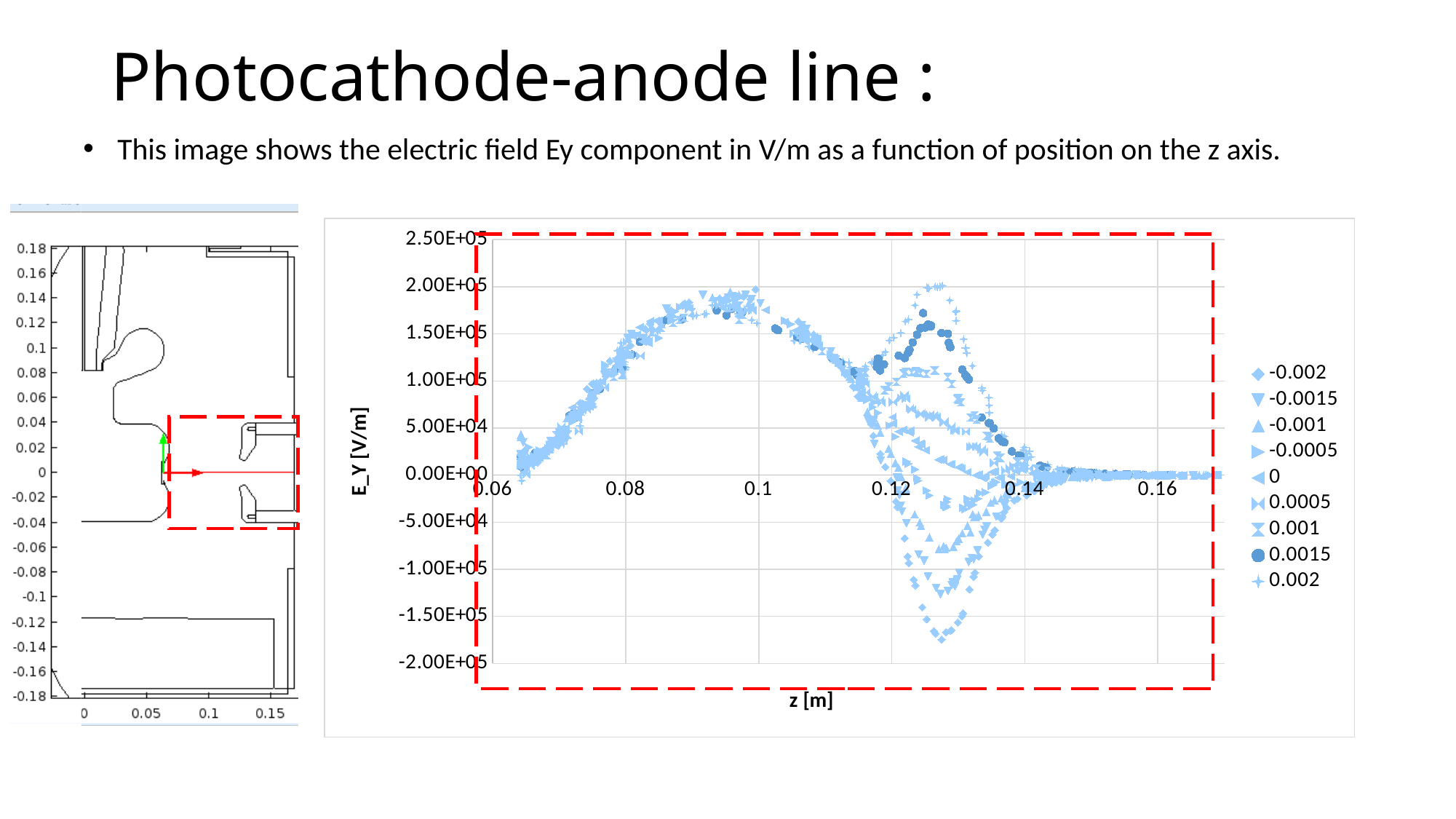
What is the label of the vertical axis of the chart? E_Y [V/m] Near z = 0.125, is the peak of the 0.002 series higher or lower than the peak of the 0.0015 series? higher Are the values of the plotted data at z = 0.16 greater or less than 5.00E+04? less How many series does the legend of the chart list? 9 Which series in the legend is drawn with a filled circle marker? 0.0015 Is the peak value of the plotted data near z = 0.1 greater or less than 1.50E+05? greater Between z = 0.07 and z = 0.09, do the plotted values rise or fall along the x axis? rise Which series reaches the lowest value on the chart? -0.002 Is the peak value of the 0.0015 series near z = 0.125 greater or less than 1.00E+05? greater Between z = 0.1 and z = 0.115, do the plotted values rise or fall along the x axis? fall What kind of chart is shown on the slide? scatter chart